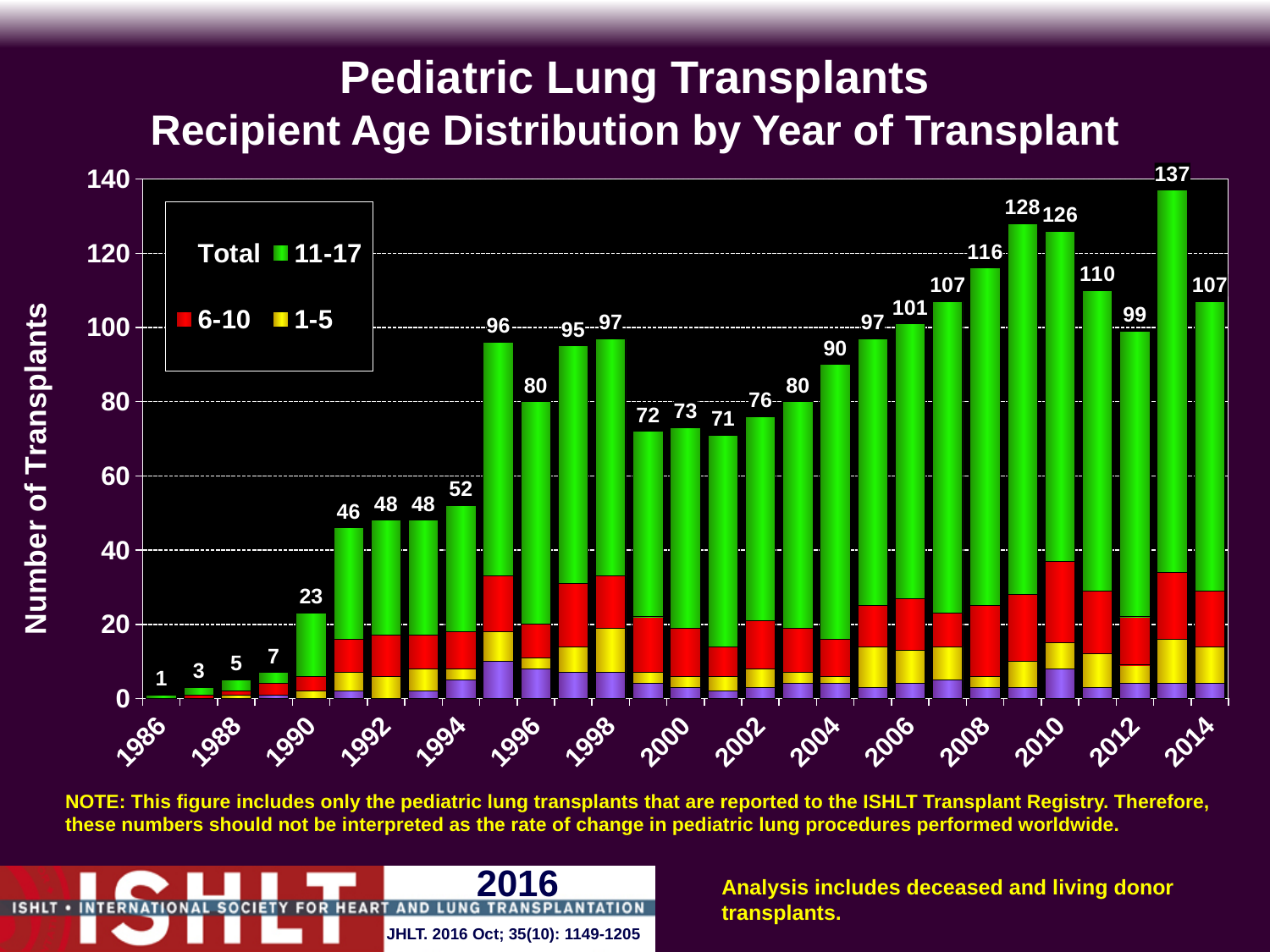
What is the total number of transplants shown for 2006? 101 How many entries does the legend list? 4 What is the difference between the total for 2013 and the total for 2014? 30 Which year has the lowest total number of transplants? 1986 What is the total number of transplants shown for 1990? 23 What is the total number of pediatric lung transplants shown for 2013? 137 Which year has a larger total, 2009 or 2010? 2009 What kind of chart is shown on the slide? Stacked bar chart Which year has the highest total number of transplants? 2013 Is the 11-17 age group segment for 2010 greater or less than 80? greater Do the total transplant numbers rise or fall from 1986 to 1995? Rise